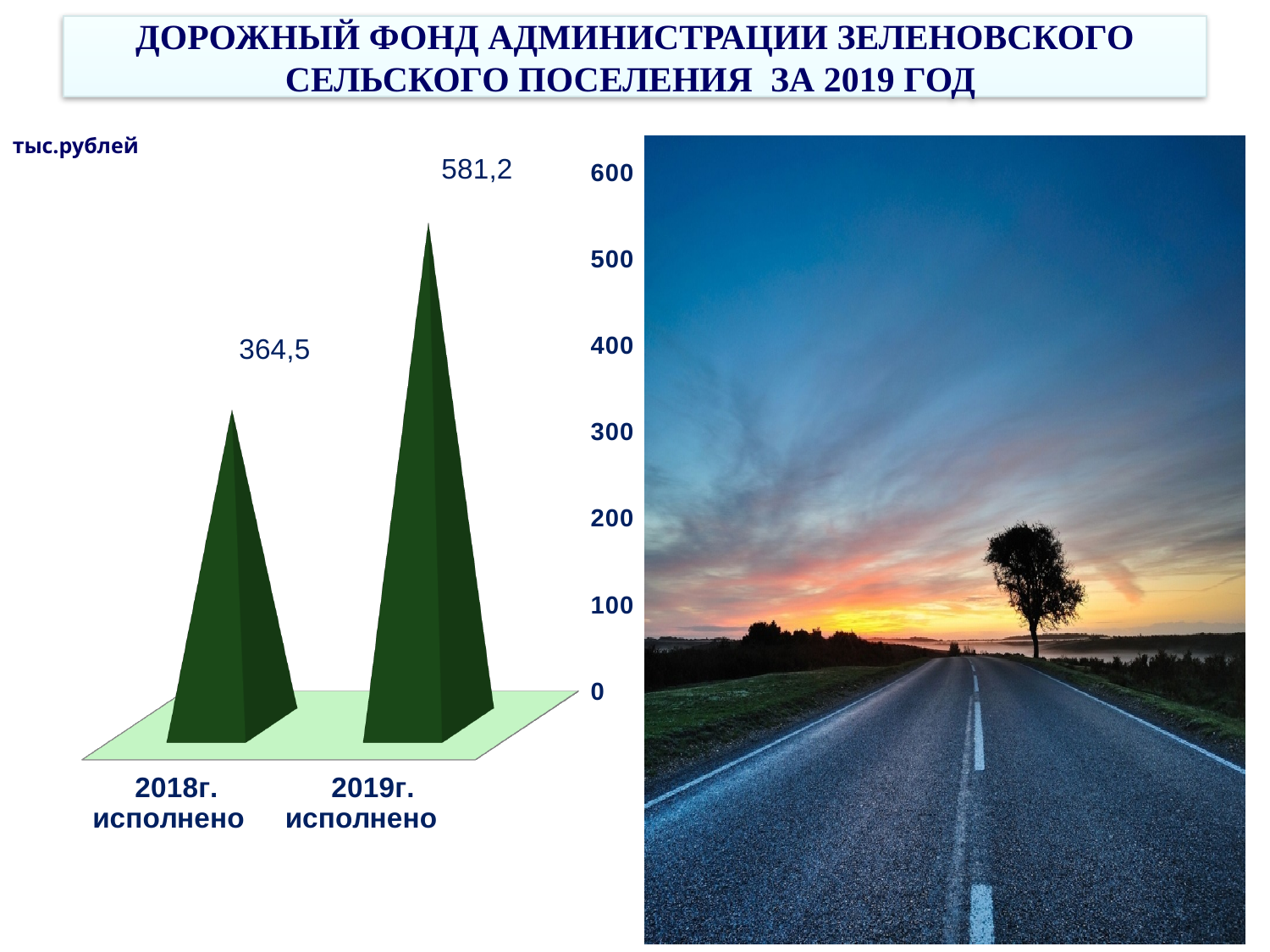
Which is larger, the value for 2018г. исполнено or 2019г. исполнено? 2019г. исполнено Is the value for 2018г. исполнено greater or less than 400? less In what units are the chart values given? тыс.рублей Do the values rise or fall from 2018г. to 2019г.? rise How many categories are shown in the chart? 2 What is the value for 2019г. исполнено? 581,2 What is the value for 2018г. исполнено? 364,5 What is the difference between the values for 2019г. исполнено and 2018г. исполнено? 216,7 Which category has the lowest value? 2018г. исполнено Is the value for 2019г. исполнено greater or less than 500? greater Which category has the highest value? 2019г. исполнено What kind of chart is shown on the slide? bar chart